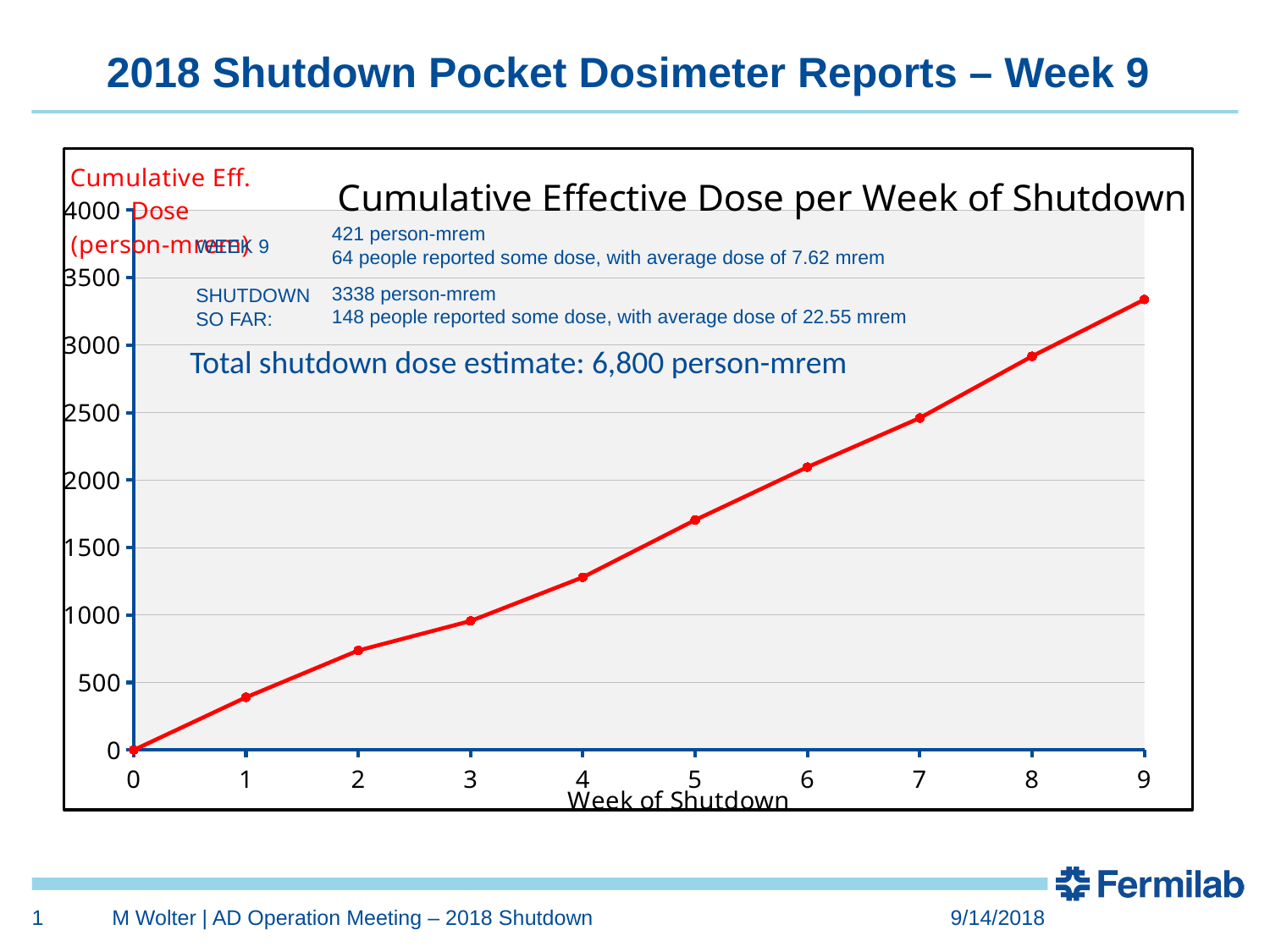
At which week of shutdown is the cumulative effective dose lowest? 0 Which has a larger cumulative effective dose, week 3 or week 5? week 5 At which week of shutdown is the cumulative effective dose highest? 9 Do the values rise or fall as the week of shutdown increases? rise What kind of chart is shown on the slide? line chart What is the cumulative effective dose at week 0? 0 How many data points are plotted on the line? 10 What is the label of the x axis of the chart? Week of Shutdown Is the value for week 1 greater or less than 500? less What is the title of the chart? Cumulative Effective Dose per Week of Shutdown Is the value for week 8 greater or less than 3000? less Is the value for week 4 greater or less than 1000? greater